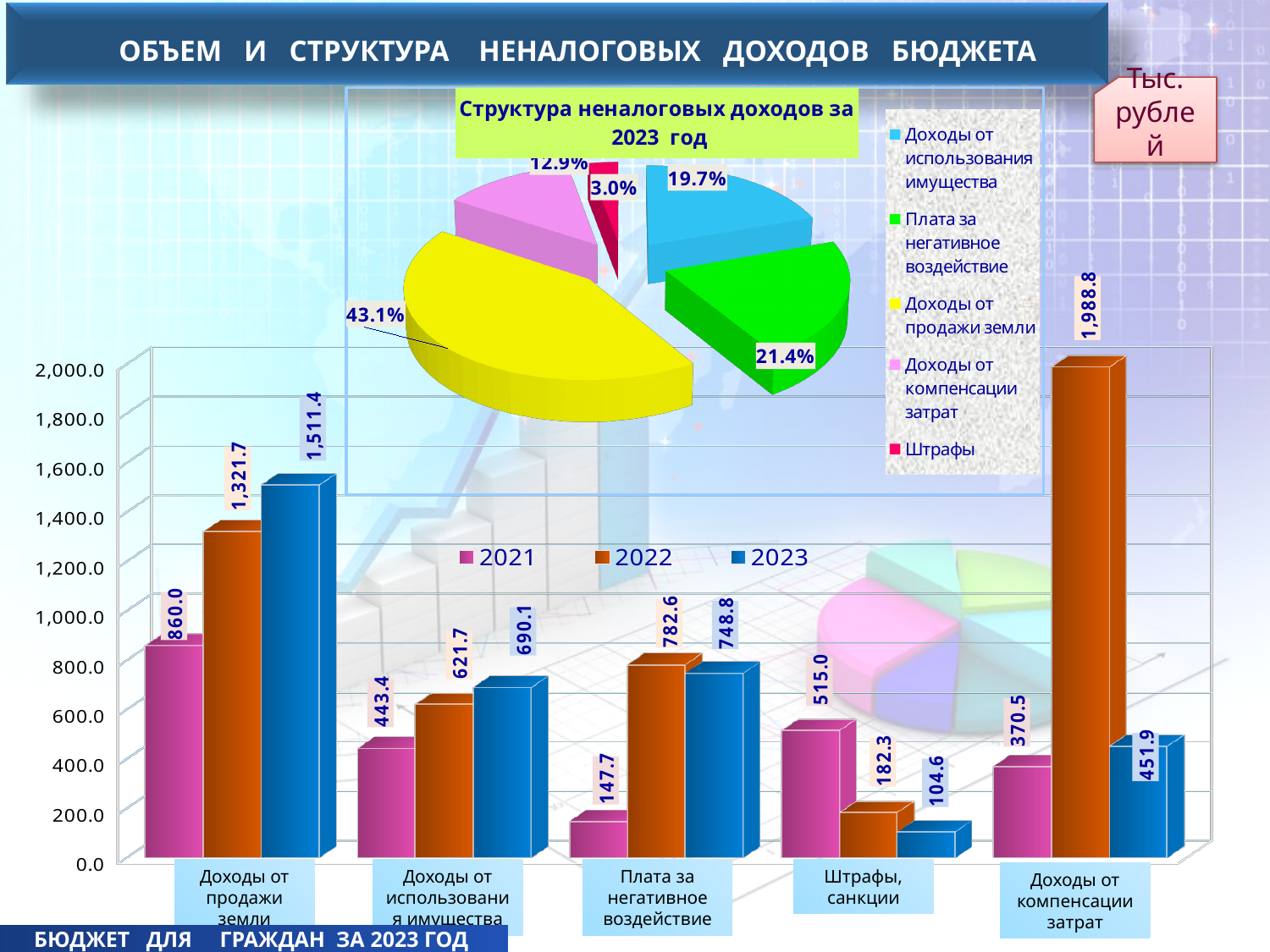
In the bar chart at the bottom of the slide, what is the 2023 value for 'Штрафы, санкции'? 104.6 In the bar chart at the bottom of the slide, what is the 2021 value for 'Плата за негативное воздействие'? 147.7 In the pie chart 'Структура неналоговых доходов за 2023 год', what share is shown for 'Доходы от продажи земли'? 43.1% In the bar chart at the bottom of the slide, which category has the lowest 2023 value? Штрафы, санкции In the pie chart 'Структура неналоговых доходов за 2023 год', how many categories does the legend list? 5 In the bar chart at the bottom of the slide, what is the 2022 value for 'Доходы от компенсации затрат'? 1,988.8 What type of chart is the chart at the bottom of the slide? Bar chart In the pie chart 'Структура неналоговых доходов за 2023 год', what share is shown for 'Штрафы'? 3.0% In the bar chart at the bottom of the slide, which is larger for 'Плата за негативное воздействие': the 2022 value or the 2023 value? 2022 In the bar chart at the bottom of the slide, how many series does the legend list? 3 In the pie chart 'Структура неналоговых доходов за 2023 год', which category has the largest slice? Доходы от продажи земли In the bar chart at the bottom of the slide, what is the difference between the 2023 and 2021 values for 'Доходы от продажи земли'? 651.4